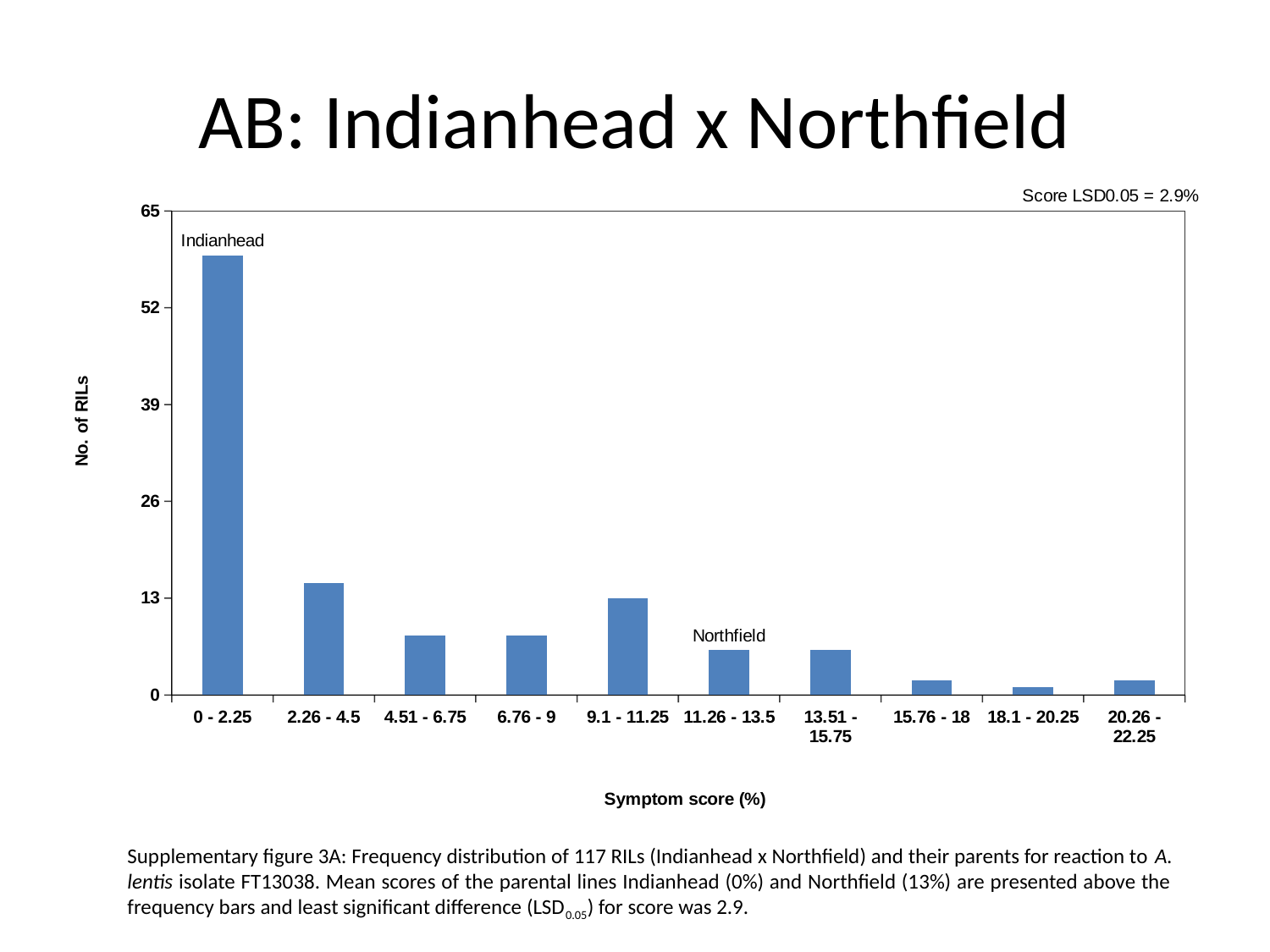
Is the number of RILs for the 4.51 - 6.75 category greater or less than 13? less Is the number of RILs for the 0 - 2.25 category greater or less than 52? greater What is the label of the x axis? Symptom score (%) What kind of chart is shown on the slide? bar chart Is the number of RILs for the 15.76 - 18 category greater or less than 13? less Which symptom score category has the highest number of RILs? 0 - 2.25 Which has more RILs, the 9.1 - 11.25 category or the 11.26 - 13.5 category? 9.1 - 11.25 Which symptom score category has the lowest number of RILs? 18.1 - 20.25 Which parental line is labelled above the 0 - 2.25 bar? Indianhead Which has more RILs, the 2.26 - 4.5 category or the 4.51 - 6.75 category? 2.26 - 4.5 How many symptom score categories are shown on the x axis? 10